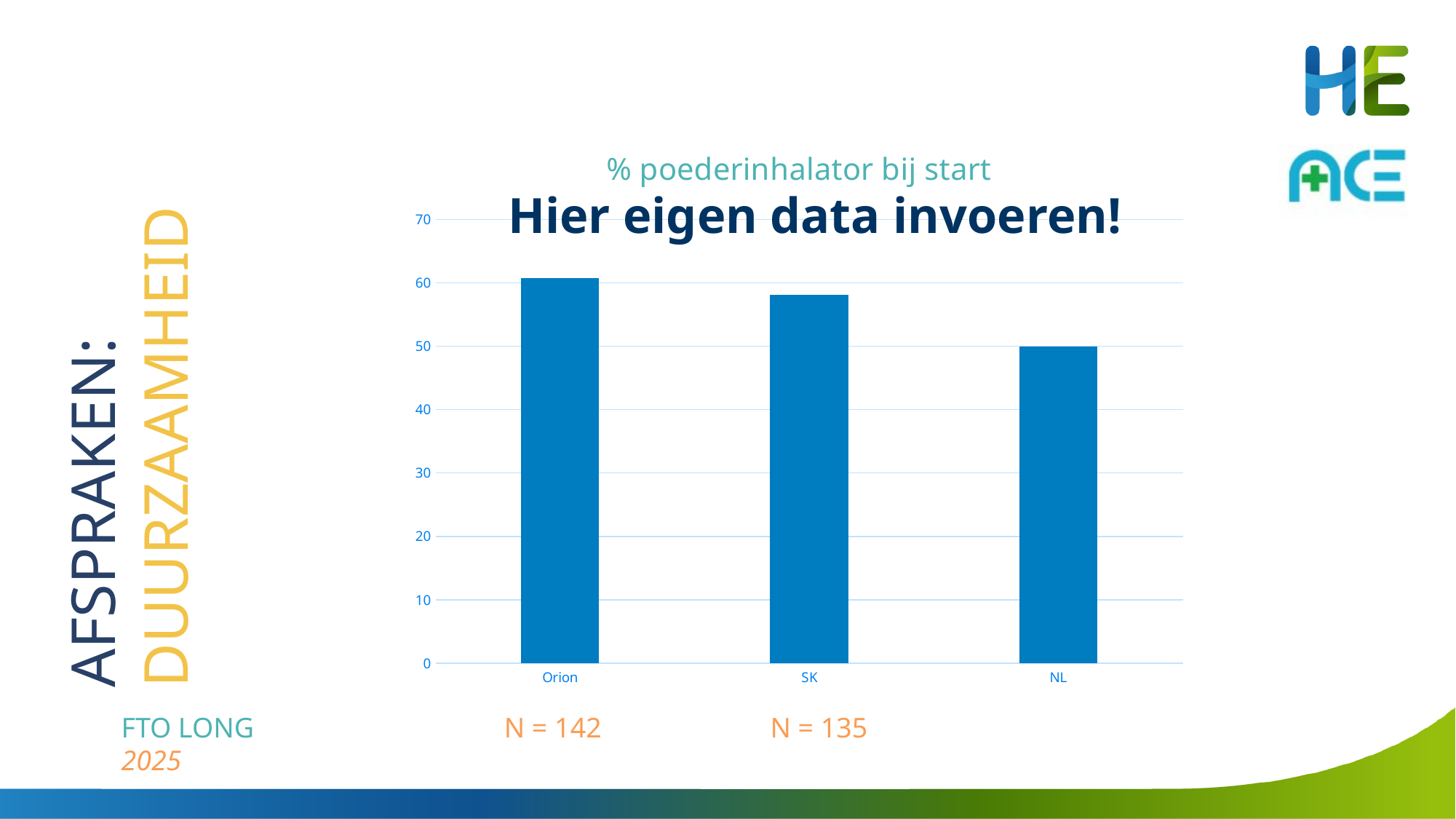
Which category has the highest value in the chart? Orion What is the title of the chart? % poederinhalator bij start Which is larger, the value for Orion or the value for NL? Orion Is the value for Orion greater or less than 50? greater Do the values rise or fall from Orion to NL along the x axis? fall How many categories are plotted in the chart? 3 What is the value for NL in the chart? 50 Is the value for SK greater or less than 50? greater Is the value for NL greater or less than 60? less What kind of chart is shown on the slide? bar chart Which category has the lowest value in the chart? NL Which is larger, the value for SK or the value for NL? SK